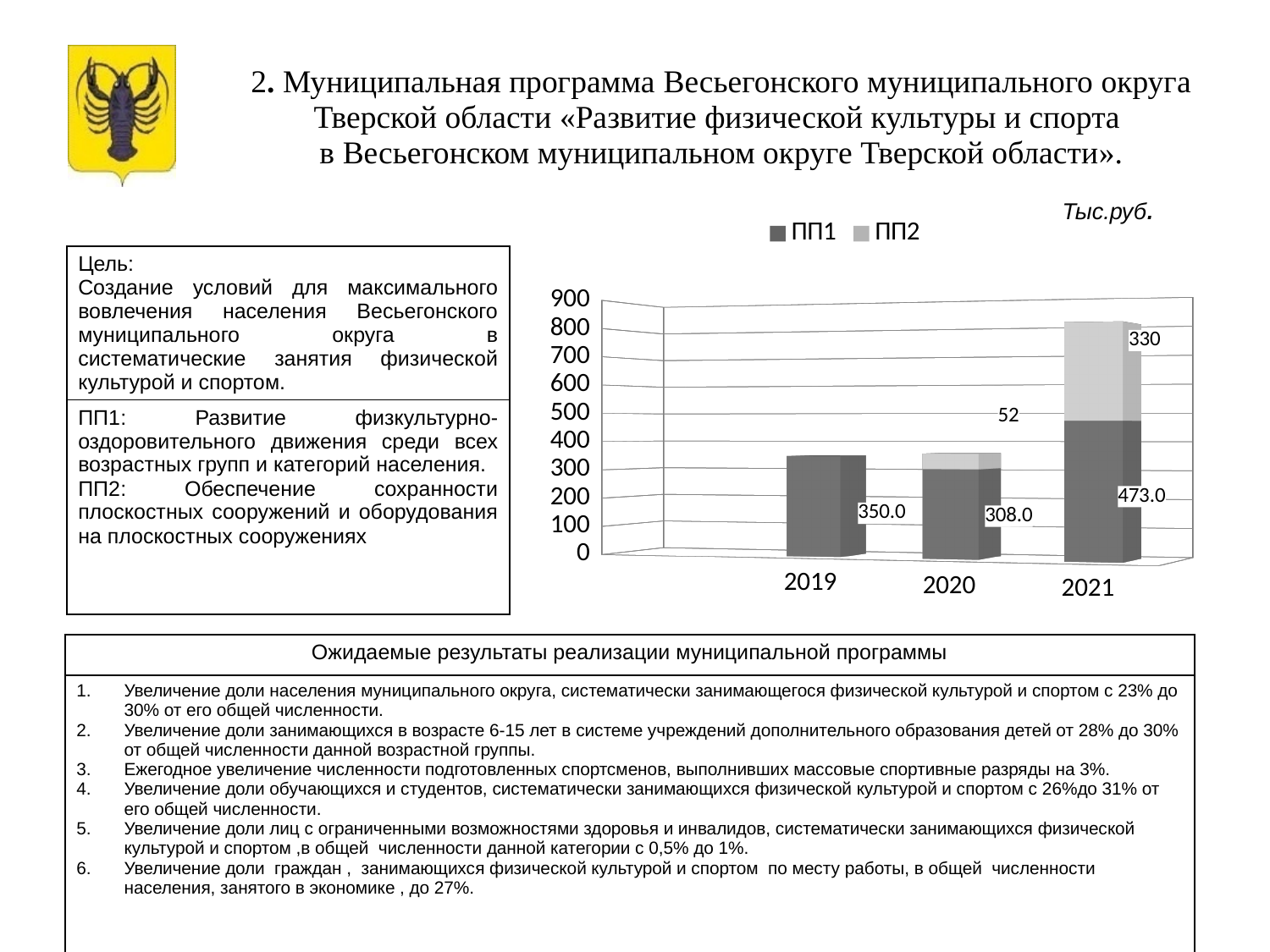
Which is larger: ПП2 for 2021 or ПП2 for 2020? ПП2 for 2021 What is the value of ПП2 for 2020? 52 What is the total of the stacked bar for 2021? 803.0 Which year has the highest ПП1 value? 2021 What is the value of ПП1 for 2020? 308.0 What is the difference between the ПП1 values for 2021 and 2020? 165.0 What kind of chart is shown on the slide? Stacked bar chart Which year has the lowest ПП1 value? 2020 What is the value of ПП2 for 2021? 330 What is the value of ПП1 for 2021? 473.0 How many series does the legend list? 2 What is the value of ПП1 for 2019? 350.0